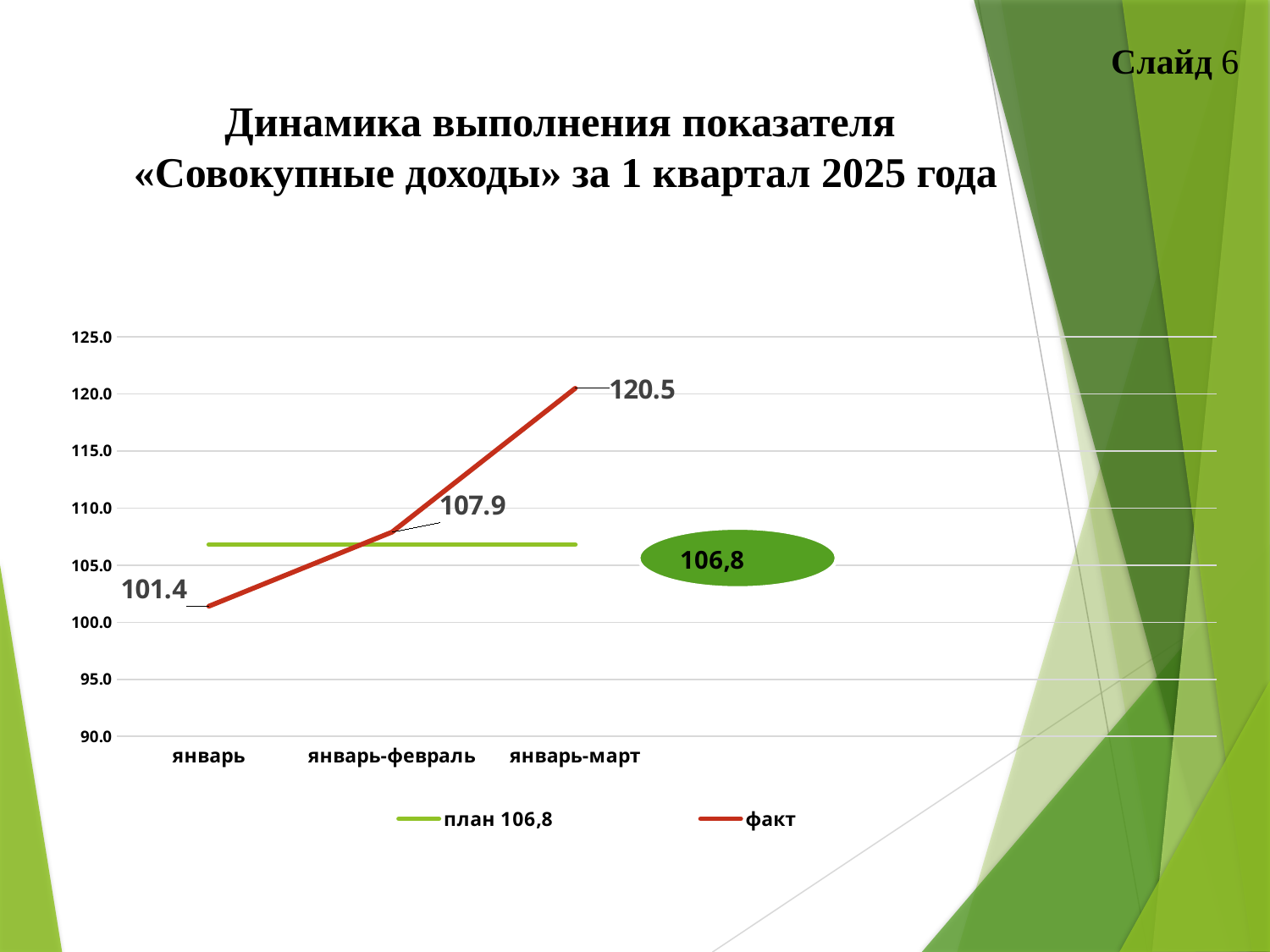
What is the value of the факт series for январь-февраль? 107.9 What is the value of the факт series for январь-март? 120.5 For which period is the факт value lowest? январь Which is larger, the факт value for январь-февраль or for январь? январь-февраль How many series does the legend list? 2 What is the value of the факт series for январь? 101.4 What is the difference between the факт values for январь-март and январь? 19.1 Does the факт series rise or fall from январь to январь-март? rise For which period is the факт value highest? январь-март How many periods are shown on the x axis? 3 What kind of chart is shown on the slide? line chart What is the difference between the факт values for январь-февраль and январь? 6.5